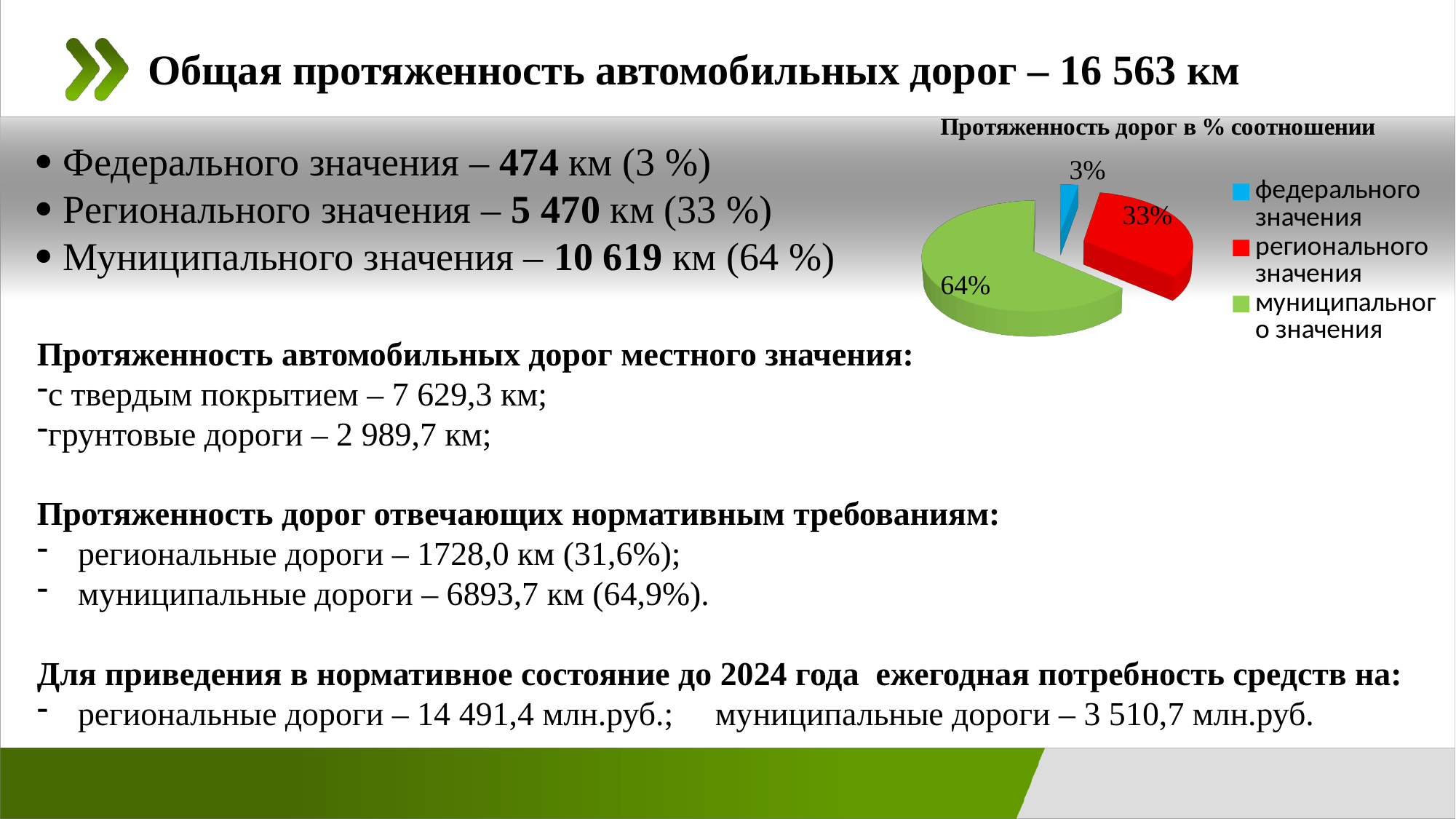
What colour is the slice for муниципального значения in the pie chart? green By how many percentage points does the муниципального значения slice exceed the регионального значения slice? 31 What share of the pie chart is labelled for регионального значения? 33% What is the title of the pie chart? Протяженность дорог в % соотношении Which category has the largest slice in the pie chart? муниципального значения Which category has the smallest slice in the pie chart? федерального значения How many entries does the legend of the pie chart list? 3 What share of the pie chart is labelled for федерального значения? 3% How many slices does the pie chart have? 3 What share of the pie chart is labelled for муниципального значения? 64% In the pie chart, which is larger: регионального значения or федерального значения? регионального значения What kind of chart is shown on the slide? pie chart